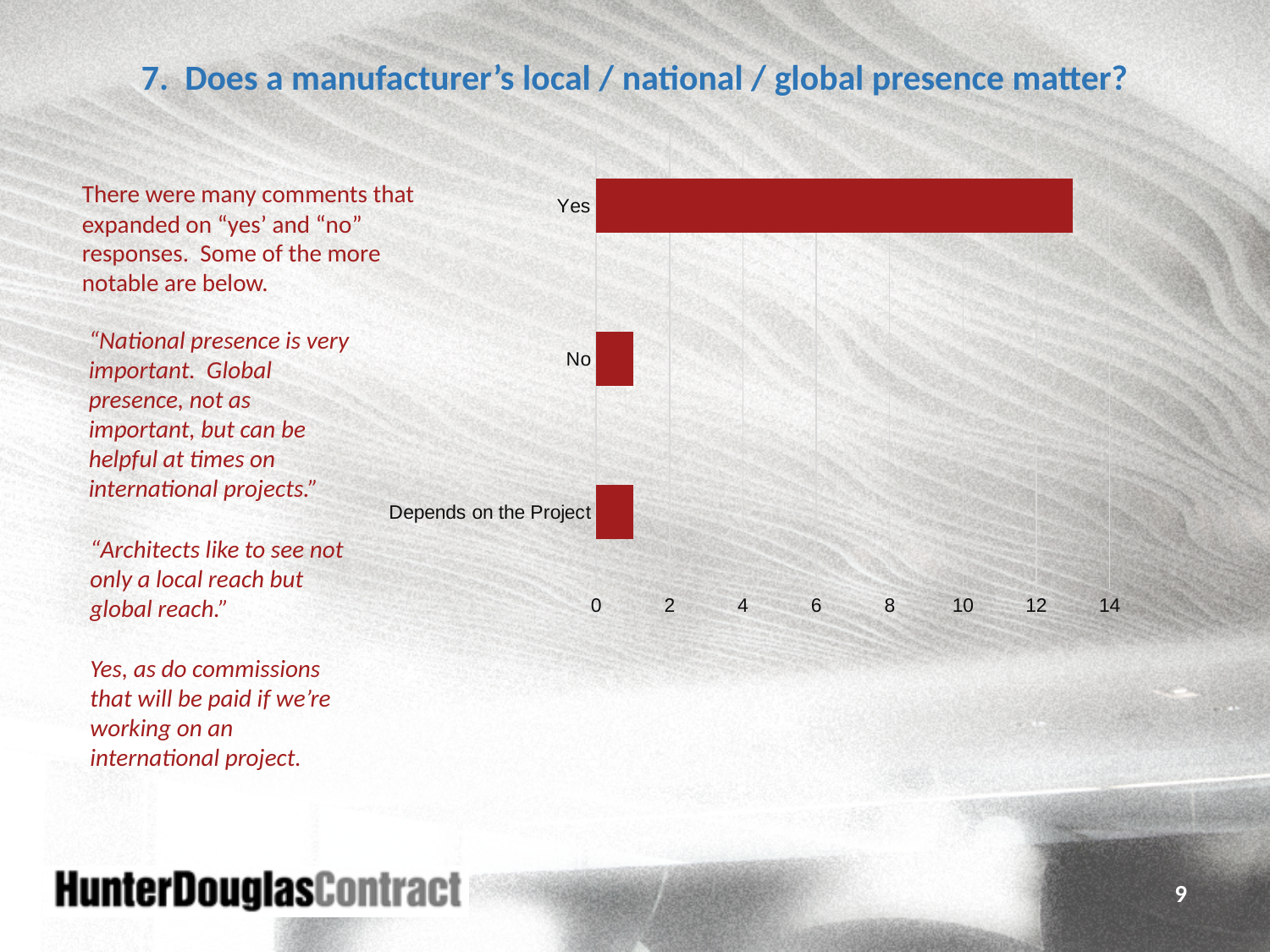
What kind of chart is shown on the slide? bar chart Is the value for No greater or less than 2? less Which is larger, the value for Depends on the Project or the value for Yes? Yes What colour are the bars in the chart? red Which is larger, the value for Yes or the value for No? Yes Which category has the highest value in the chart? Yes How many categories are plotted in the chart? 3 Is the value for Yes greater or less than 12? greater What is the highest tick value shown on the horizontal axis of the chart? 14 Is the value for Yes greater or less than 10? greater